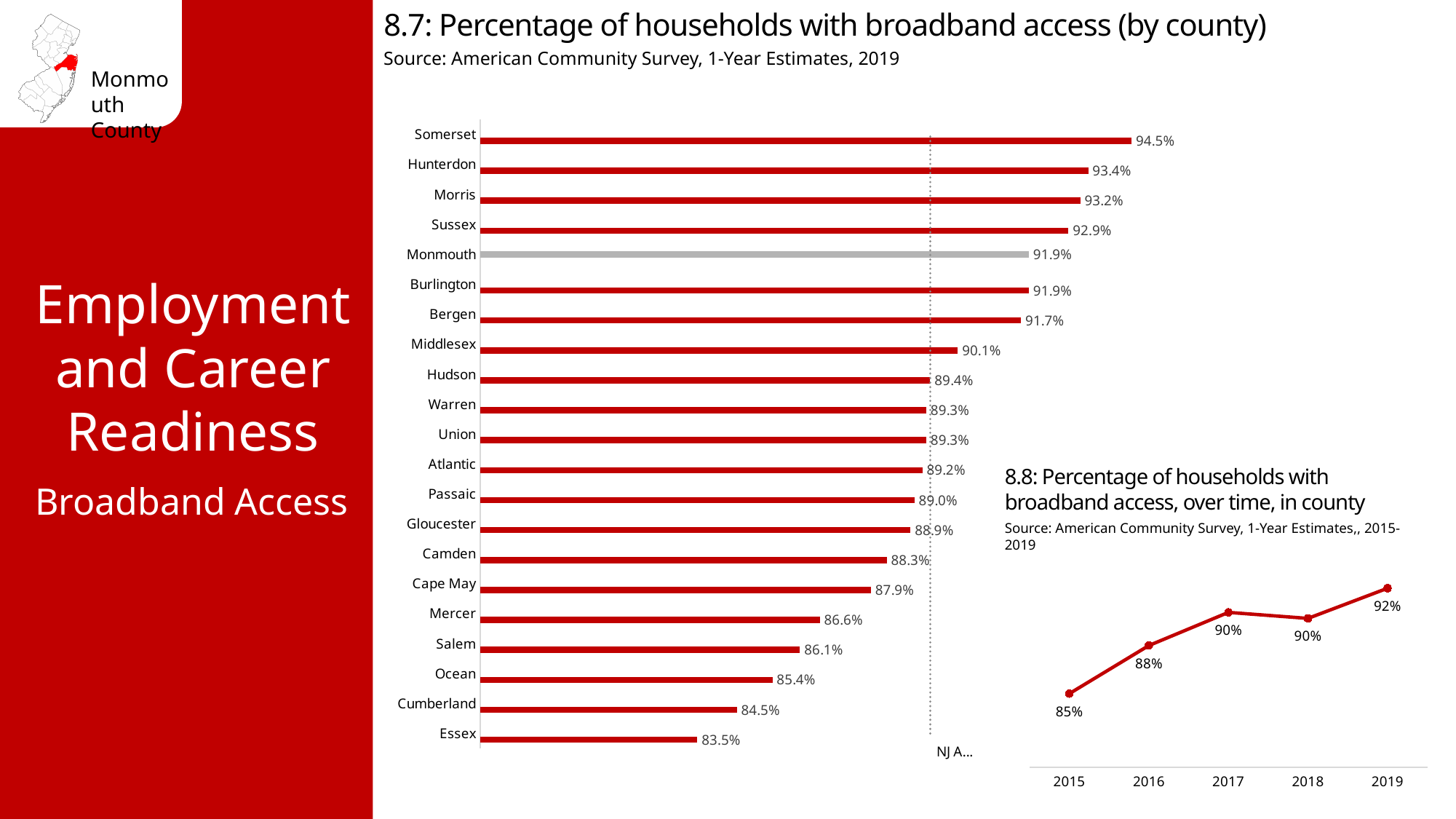
In the chart '8.7: Percentage of households with broadband access (by county)', what is the value for Cumberland? 84.5% In the chart '8.7: Percentage of households with broadband access (by county)', how many counties are shown? 21 What kind of chart is '8.7: Percentage of households with broadband access (by county)'? Bar chart In the chart '8.8: Percentage of households with broadband access, over time, in county', do the values generally rise or fall from 2015 to 2019? Rise In the chart '8.8: Percentage of households with broadband access, over time, in county', what is the value for 2019? 92% In the chart '8.8: Percentage of households with broadband access, over time, in county', what is the value for 2015? 85% In the chart '8.7: Percentage of households with broadband access (by county)', what is the difference between Somerset and Essex? 11.0% In the chart '8.7: Percentage of households with broadband access (by county)', which is larger, the value for Bergen or the value for Ocean? Bergen In the chart '8.7: Percentage of households with broadband access (by county)', which county has the highest percentage? Somerset In the chart '8.7: Percentage of households with broadband access (by county)', which county has the lowest percentage? Essex What kind of chart is '8.8: Percentage of households with broadband access, over time, in county'? Line chart In the chart '8.7: Percentage of households with broadband access (by county)', what is the value for Monmouth? 91.9%